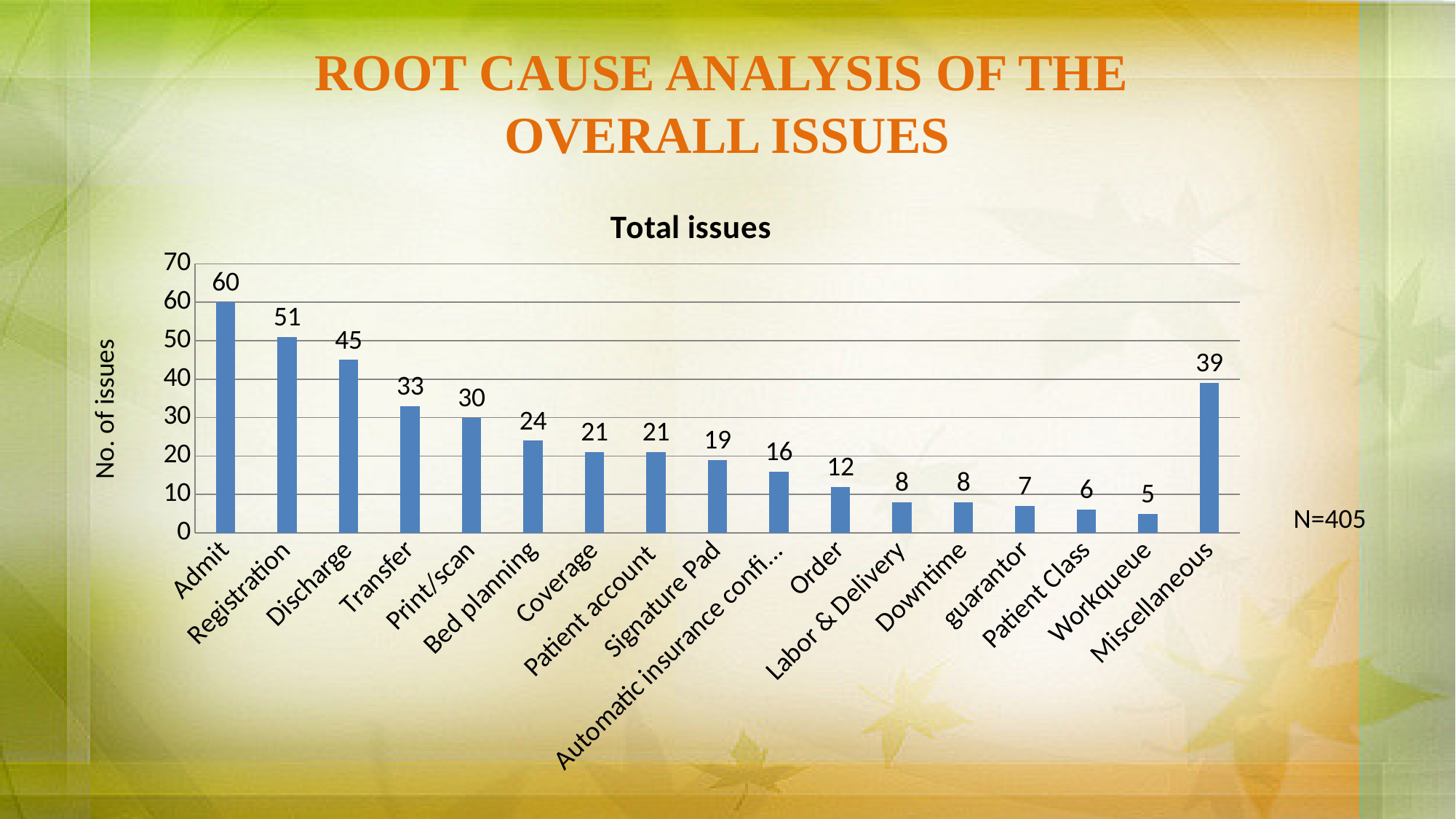
What is the value for Miscellaneous? 39 What is the difference between the values for Registration and Discharge? 6 Which is larger, the value for Transfer or the value for Print/scan? Transfer What is the value for Admit? 60 Which category has the lowest number of issues? Workqueue What is the title of the chart? Total issues Which category has the highest number of issues? Admit What kind of chart is shown on the slide? Bar chart What is the difference between the values for Bed planning and Order? 12 How many categories are shown on the x axis? 17 What is the label of the y axis? No. of issues What is the value for Signature Pad? 19